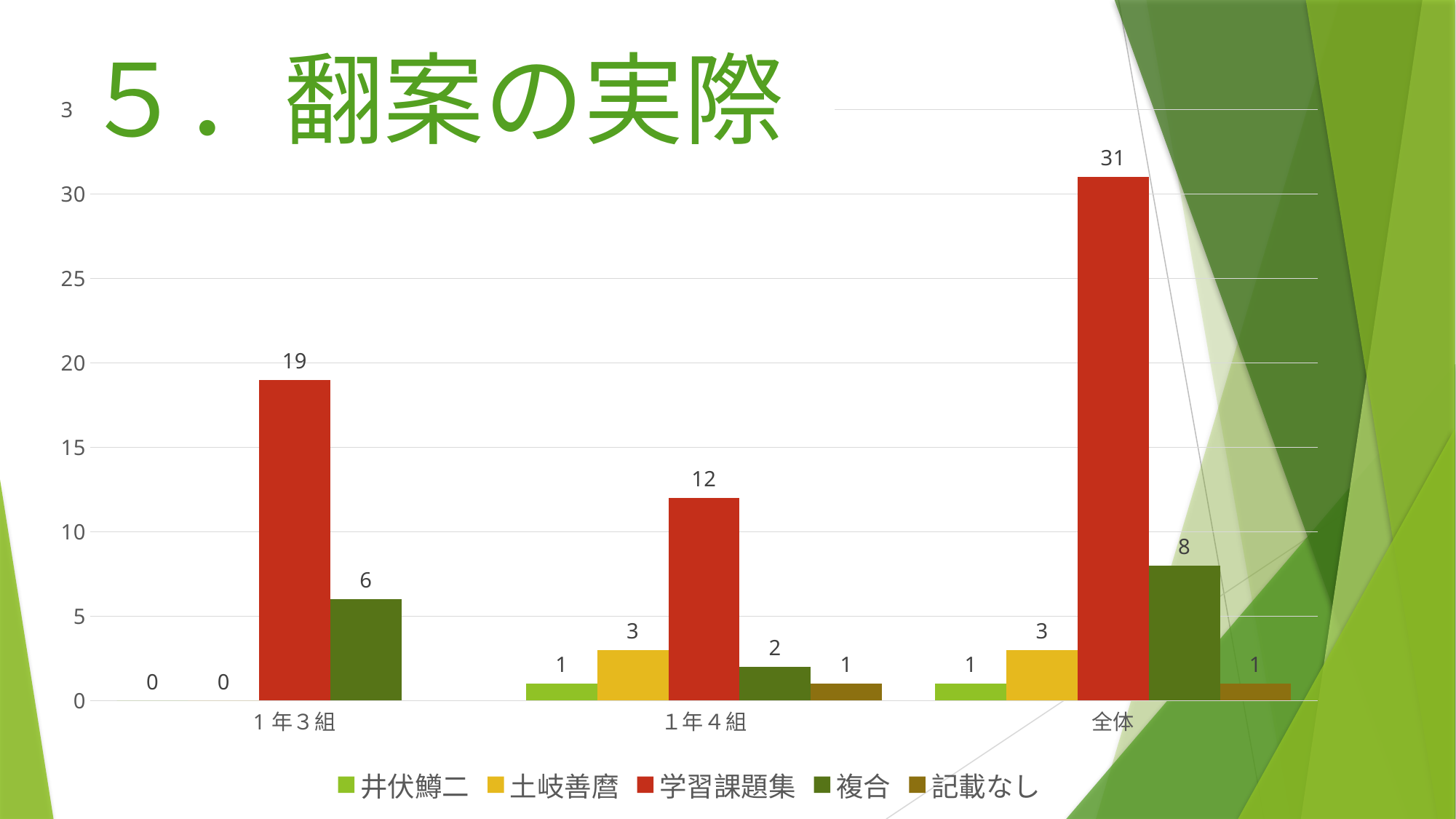
What is the value for 複合 in the 全体 category? 8 What is the difference between the 学習課題集 values for １年３組 and １年４組? 7 How many categories are shown on the x axis? 3 What is the value for 複合 in the １年４組 category? 2 Which series has the highest value in the 全体 category? 学習課題集 What is the title of the slide? ５．翻案の実際 What kind of chart is shown on the slide? bar chart What is the value for 学習課題集 in the １年３組 category? 19 Which is larger: the 複合 value for １年３組 or the 複合 value for １年４組? １年３組 What is the value for 学習課題集 in the 全体 category? 31 How many series does the legend list? 5 What is the value for 土岐善麿 in the １年４組 category? 3